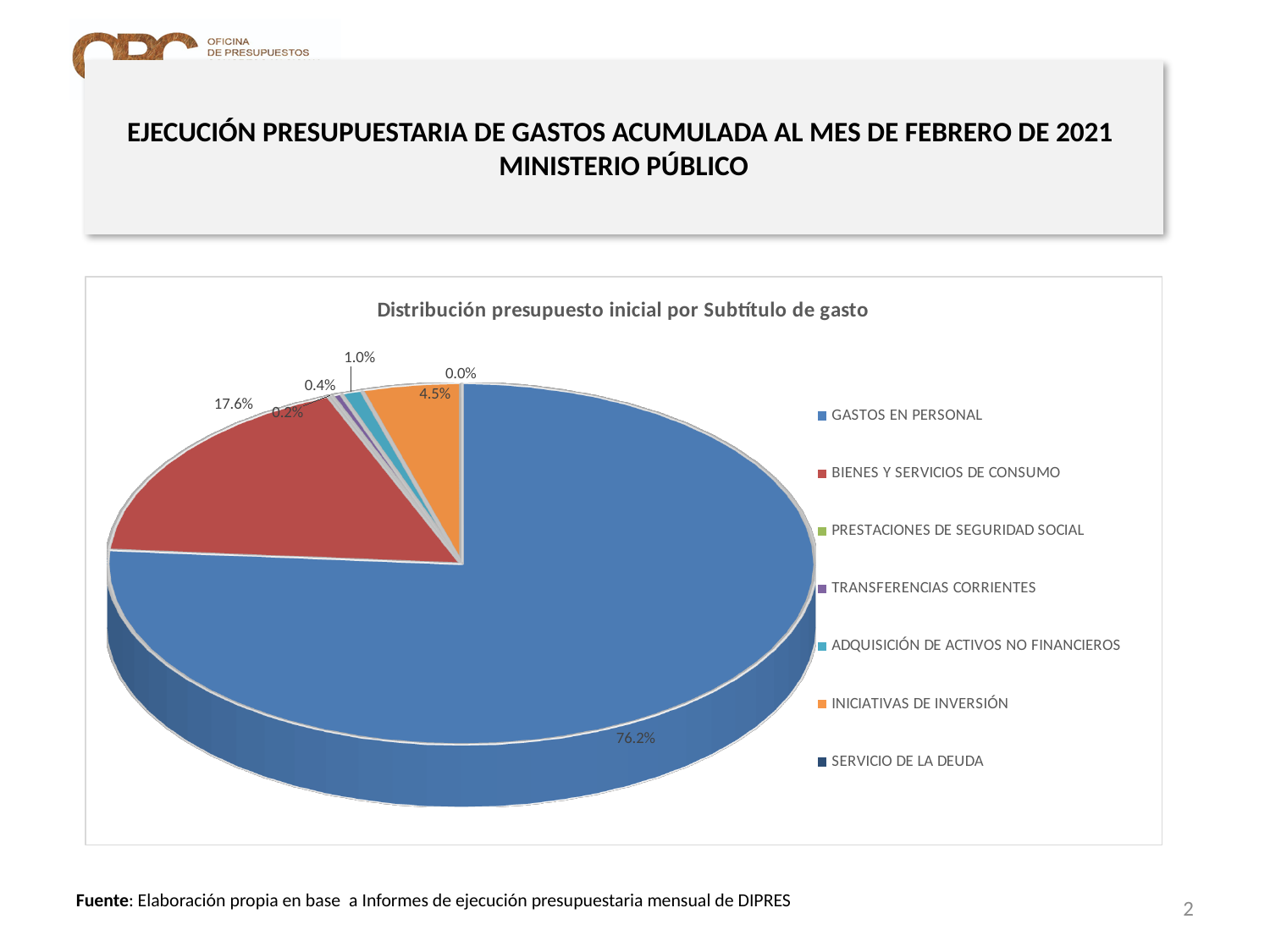
Which category has the largest share of the pie? GASTOS EN PERSONAL What is the difference between the shares of GASTOS EN PERSONAL and BIENES Y SERVICIOS DE CONSUMO? 58.6% What share of the pie does INICIATIVAS DE INVERSIÓN represent? 4.5% What share of the pie does SERVICIO DE LA DEUDA represent? 0.0% What share of the pie does ADQUISICIÓN DE ACTIVOS NO FINANCIEROS represent? 1.0% Which category has the smallest share of the pie? SERVICIO DE LA DEUDA What is the title of the chart? Distribución presupuesto inicial por Subtítulo de gasto Which is larger, the share of INICIATIVAS DE INVERSIÓN or the share of ADQUISICIÓN DE ACTIVOS NO FINANCIEROS? INICIATIVAS DE INVERSIÓN How many entries does the chart legend list? 7 What kind of chart is shown on the slide? Pie chart